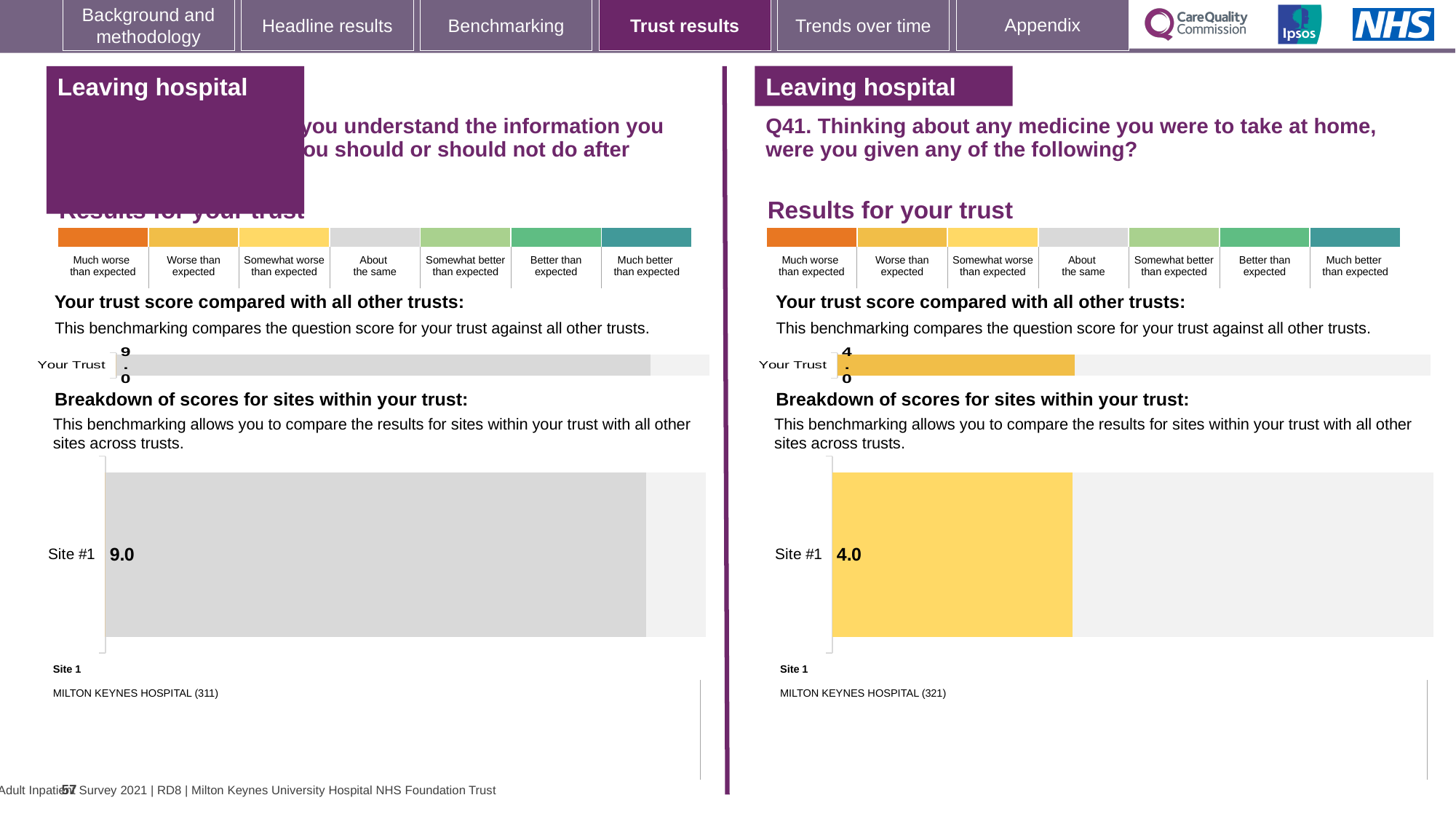
On the right-hand chart (Q41), what is the score shown for Site #1? 4.0 On the left-hand panel, what is the 'Your Trust' score shown in the benchmarking bar? 9.0 What is the difference between the Site #1 score on the left-hand chart (9.0) and the Site #1 score on the right-hand chart (4.0)? 5.0 What kind of chart is used to show the breakdown of scores for sites within the trust on the right-hand panel? Bar chart How many sites are shown in the breakdown chart on the left-hand panel? 1 On the left-hand chart, what is the score shown for Site #1? 9.0 How many sites are shown in the breakdown chart on the right-hand panel (Q41)? 1 Which site name is listed under Site 1 on the right-hand panel (Q41)? MILTON KEYNES HOSPITAL (321) How many benchmark categories are shown in the colour key above 'Your trust score compared with all other trusts' on the right-hand panel? 7 On the right-hand panel (Q41), what is the 'Your Trust' score shown in the benchmarking bar? 4.0 Which is larger: the Site #1 score on the left-hand chart or the Site #1 score on the right-hand chart (Q41)? Left-hand chart